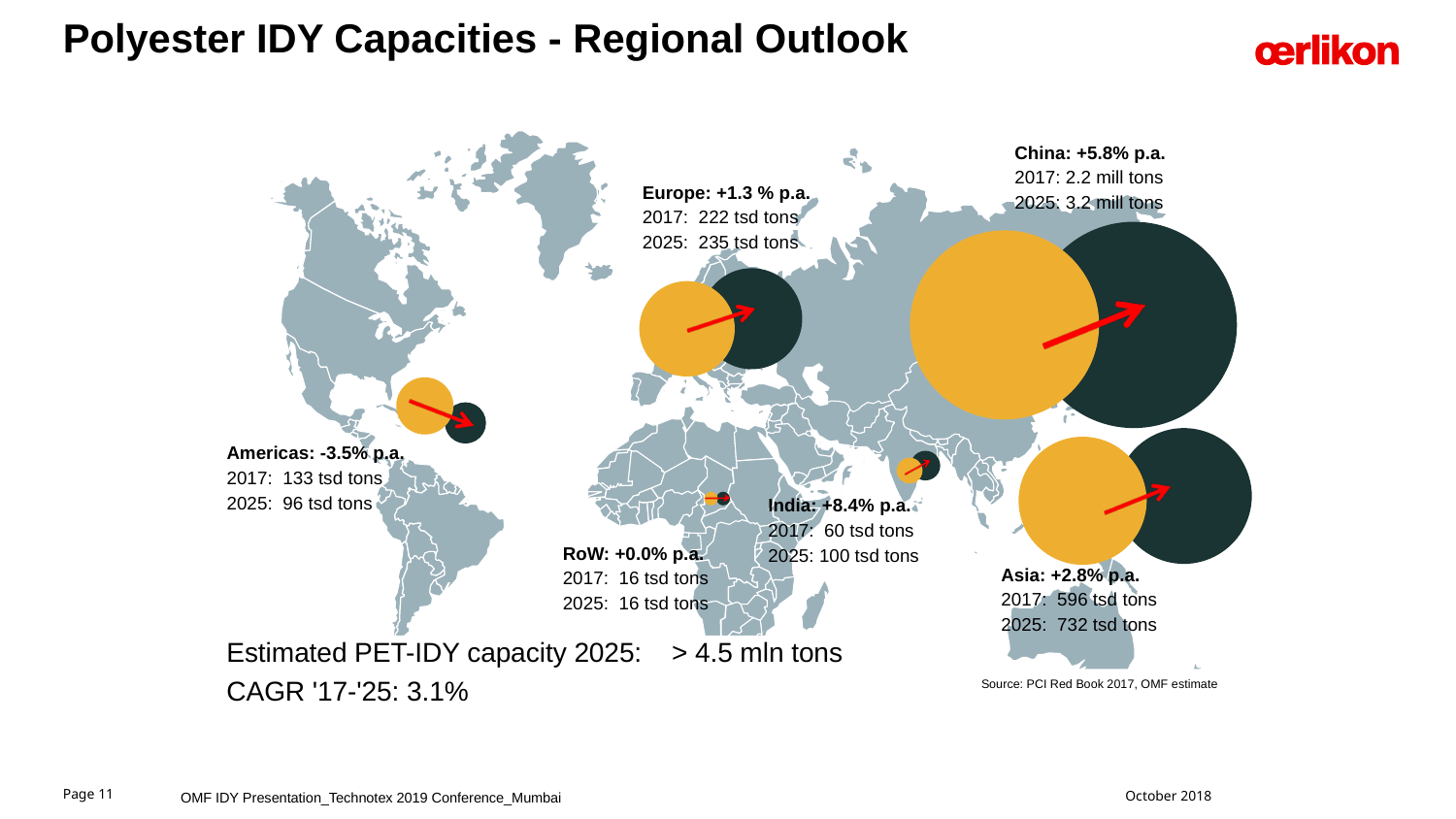
What annual growth rate is shown for India? +8.4% p.a. Which region shows the lowest annual growth rate (p.a.)? Americas By how much does Asia's capacity increase from 2017 to 2025? 136 tsd tons What CAGR for 2017-2025 is stated on the slide? 3.1% What is the 2025 capacity shown for the Americas? 96 tsd tons Which region shows the highest annual growth rate (p.a.)? India How many regions are shown with capacity figures on the map? 6 Does the capacity for RoW rise, fall or stay the same from 2017 to 2025? Stays the same By how much does India's capacity increase from 2017 to 2025? 40 tsd tons What is the 2017 polyester IDY capacity shown for Europe? 222 tsd tons Which has the larger 2025 capacity, Europe or Asia? Asia What is the 2025 polyester IDY capacity shown for China? 3.2 mill tons